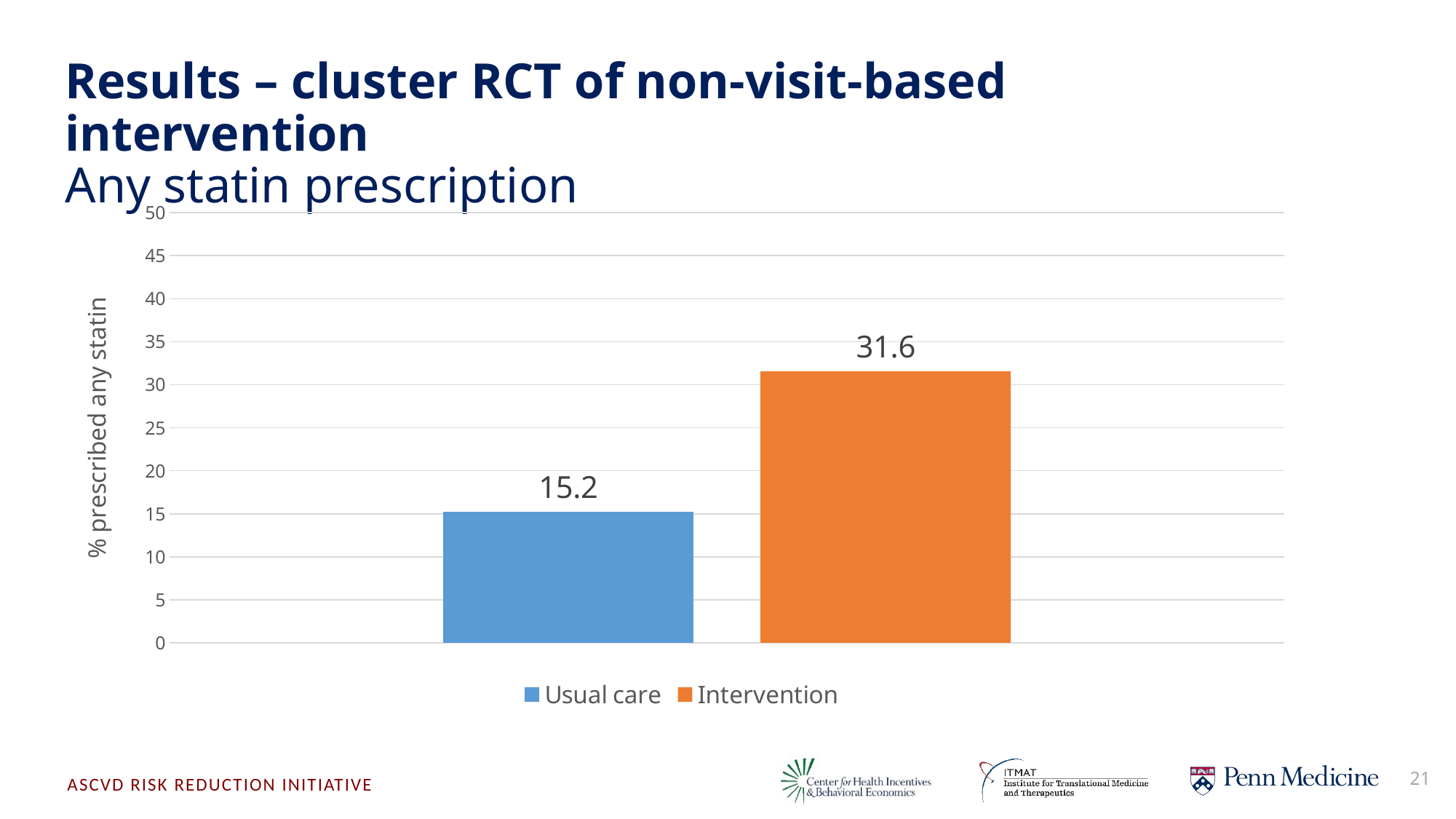
Is the value for Intervention greater or less than 30? greater Which group has the higher percentage prescribed any statin? Intervention Which group has the lower percentage prescribed any statin? Usual care What is the difference between the Intervention and Usual care values? 16.4 What is the value for Usual care? 15.2 How many bars are plotted in the chart? 2 What kind of chart is shown on the slide? bar chart What is the label of the vertical axis? % prescribed any statin How many entries does the legend list? 2 Is the value for Usual care larger or smaller than the value for Intervention? smaller What is the value for Intervention? 31.6 Is the value for Usual care greater or less than 20? less